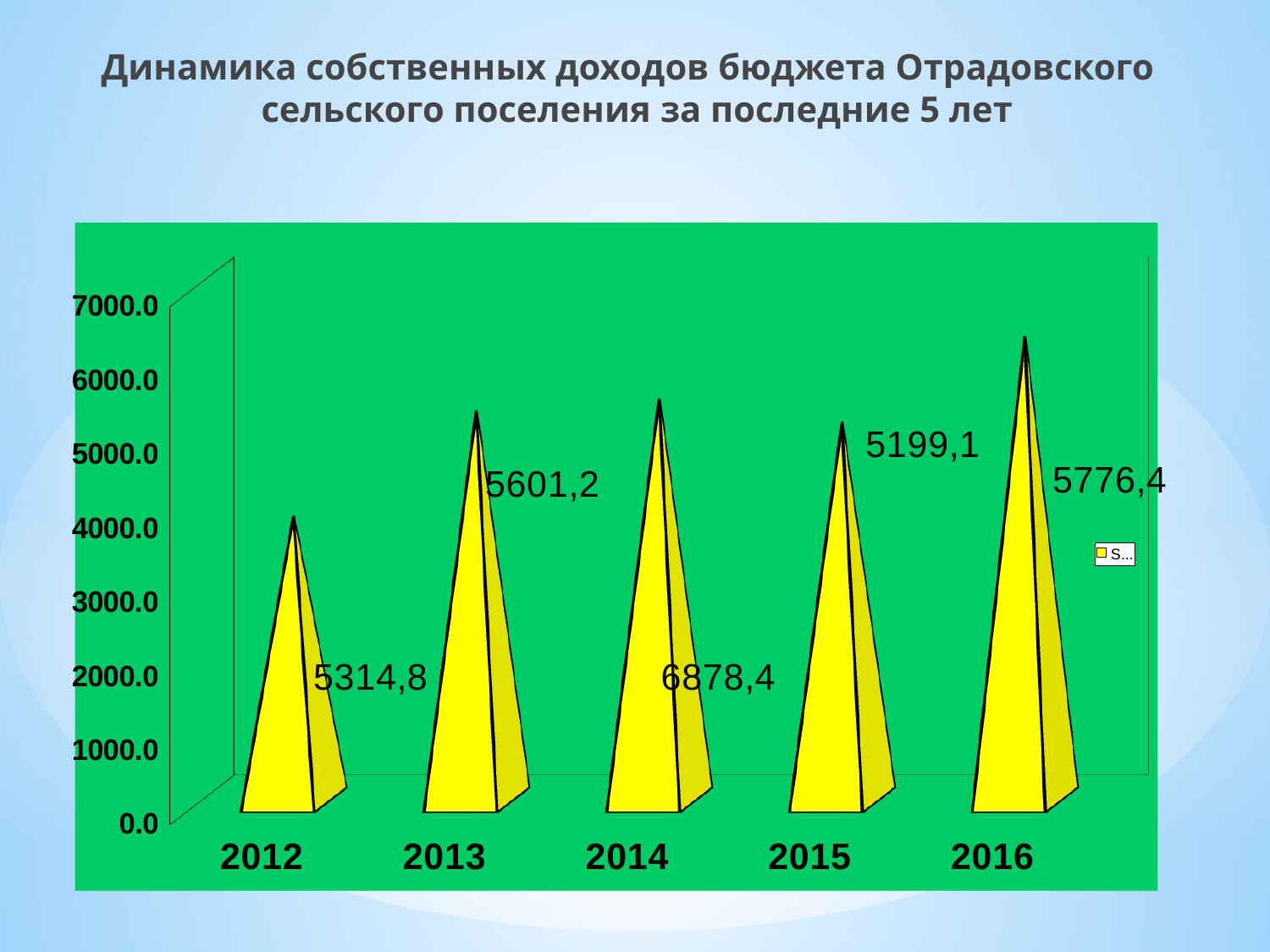
What kind of chart is shown on the slide? bar chart What is the value shown for 2012? 5314,8 What is the title of the slide? Динамика собственных доходов бюджета Отрадовского сельского поселения за последние 5 лет What is the value shown for 2013? 5601,2 What is the value shown for 2014? 6878,4 What is the value shown for 2016? 5776,4 Which is larger, the value for 2013 or the value for 2012? 2013 Which is larger, the value for 2016 or the value for 2015? 2016 Is the value for 2016 greater or less than 5000? greater What is the value shown for 2015? 5199,1 What is the difference between the values for 2016 and 2015? 577,3 How many years are shown on the x axis? 5